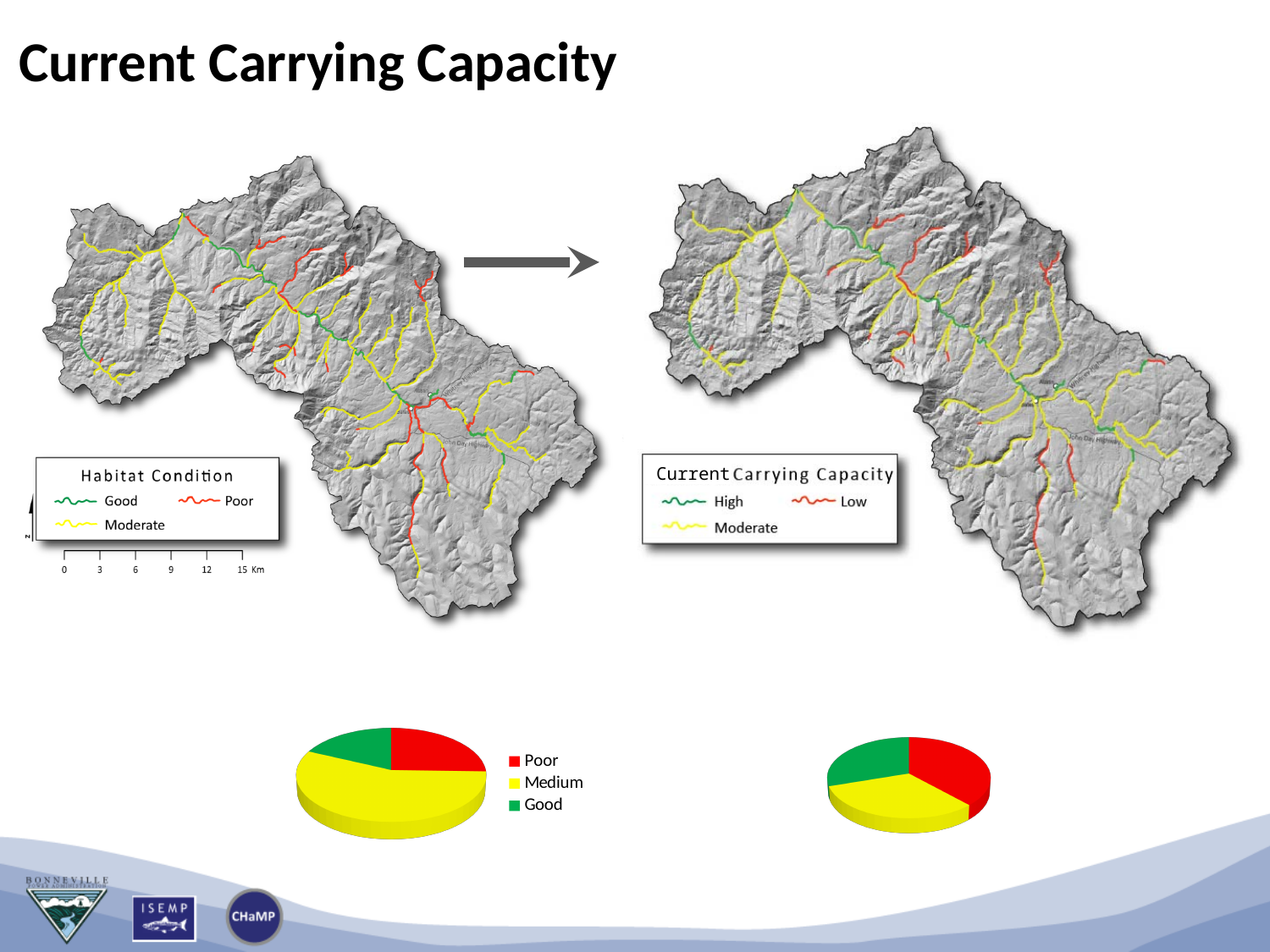
In the left pie chart, which slice is larger, Poor or Good? Poor What colour represents the Medium category in the left pie chart's legend? Yellow In the left pie chart, which category has the smallest slice? Good In the left pie chart, which slice is larger, Medium or Poor? Medium In the left pie chart, which category has the largest slice? Medium What colour represents the Poor category in the left pie chart's legend? Red How many slices does the left pie chart have? 3 How many entries does the legend of the left pie chart list? 3 How many slices does the right pie chart have? 3 What kind of chart is the left chart at the bottom of the slide? Pie chart What kind of chart is the right chart at the bottom of the slide? Pie chart